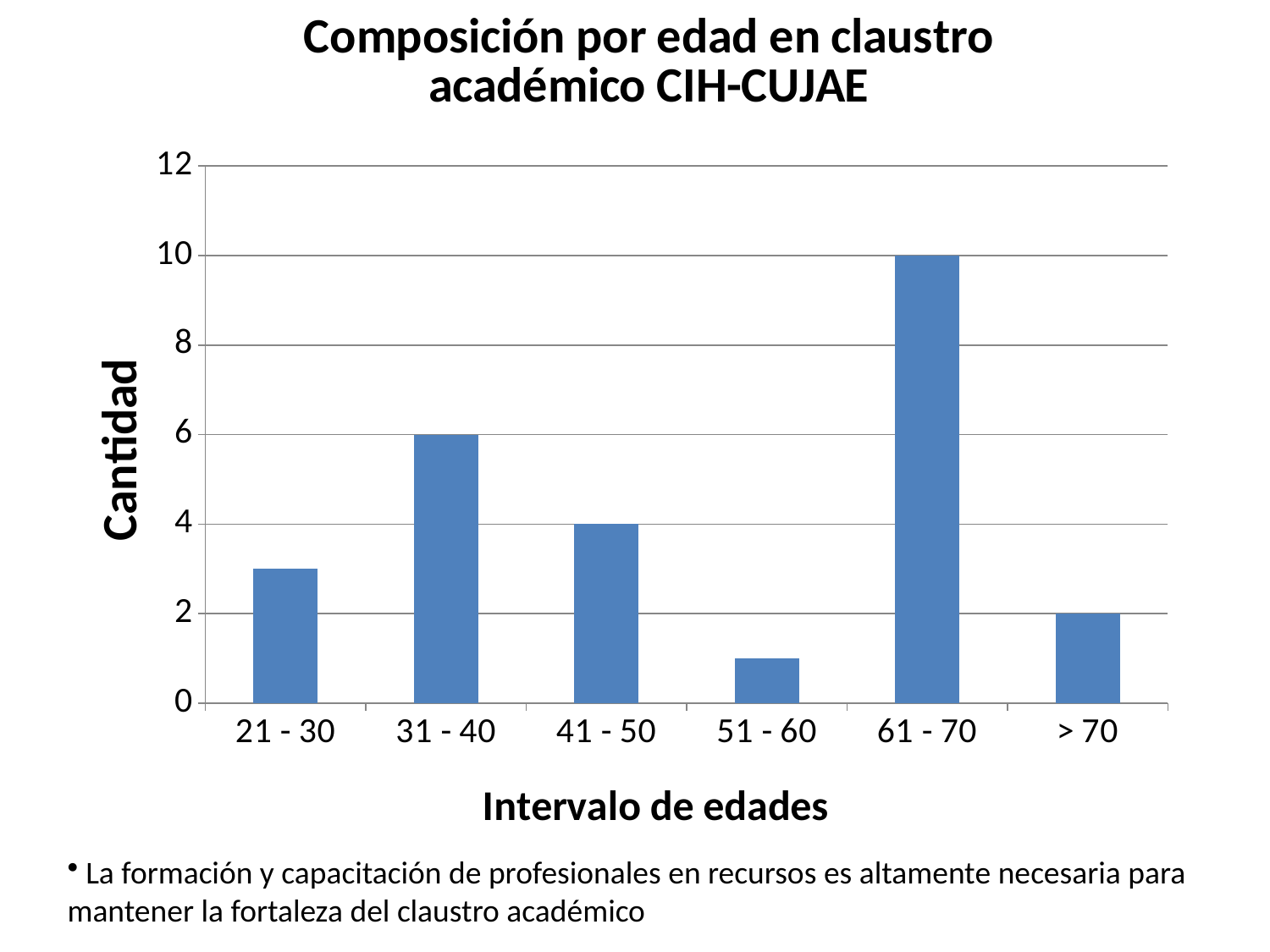
Is the value for 21 - 30 greater or less than 4? less What is the value for the 31 - 40 age interval? 6 Is the value for 51 - 60 greater or less than 2? less Which age interval has the highest value? 61 - 70 What is the value for the 41 - 50 age interval? 4 Which is larger, the value for 41 - 50 or the value for > 70? 41 - 50 What type of chart is shown on the slide? Bar chart What is the value for the > 70 age interval? 2 How many age intervals are shown on the x axis? 6 Which age interval has the lowest value? 51 - 60 What is the difference between the values for 61 - 70 and 31 - 40? 4 What is the value for the 61 - 70 age interval? 10